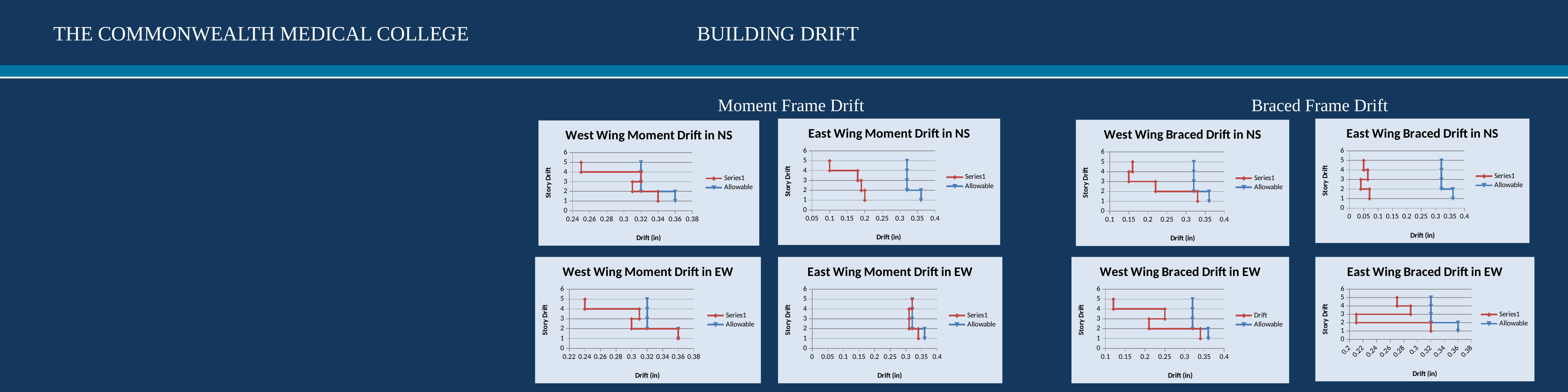
In "East Wing Moment Drift in NS", is the Allowable value at story 1 greater or less than 0.3? greater What are the two legend entries in "West Wing Braced Drift in EW"? Drift and Allowable How many series does the legend of "East Wing Moment Drift in NS" list? 2 In "West Wing Braced Drift in EW", is the Drift value at story 5 greater or less than 0.2? less What kind of chart is "West Wing Moment Drift in NS"? line chart In "East Wing Braced Drift in NS", is the Allowable value at story 5 greater or less than 0.2? greater How many charts are shown under the heading "Braced Frame Drift"? 4 In "West Wing Moment Drift in EW", which series has the larger drift at story 5, Series1 or Allowable? Allowable In "East Wing Moment Drift in NS", which series has the larger drift at story 5, Series1 or Allowable? Allowable What is the x-axis title of "East Wing Braced Drift in NS"? Drift (in)